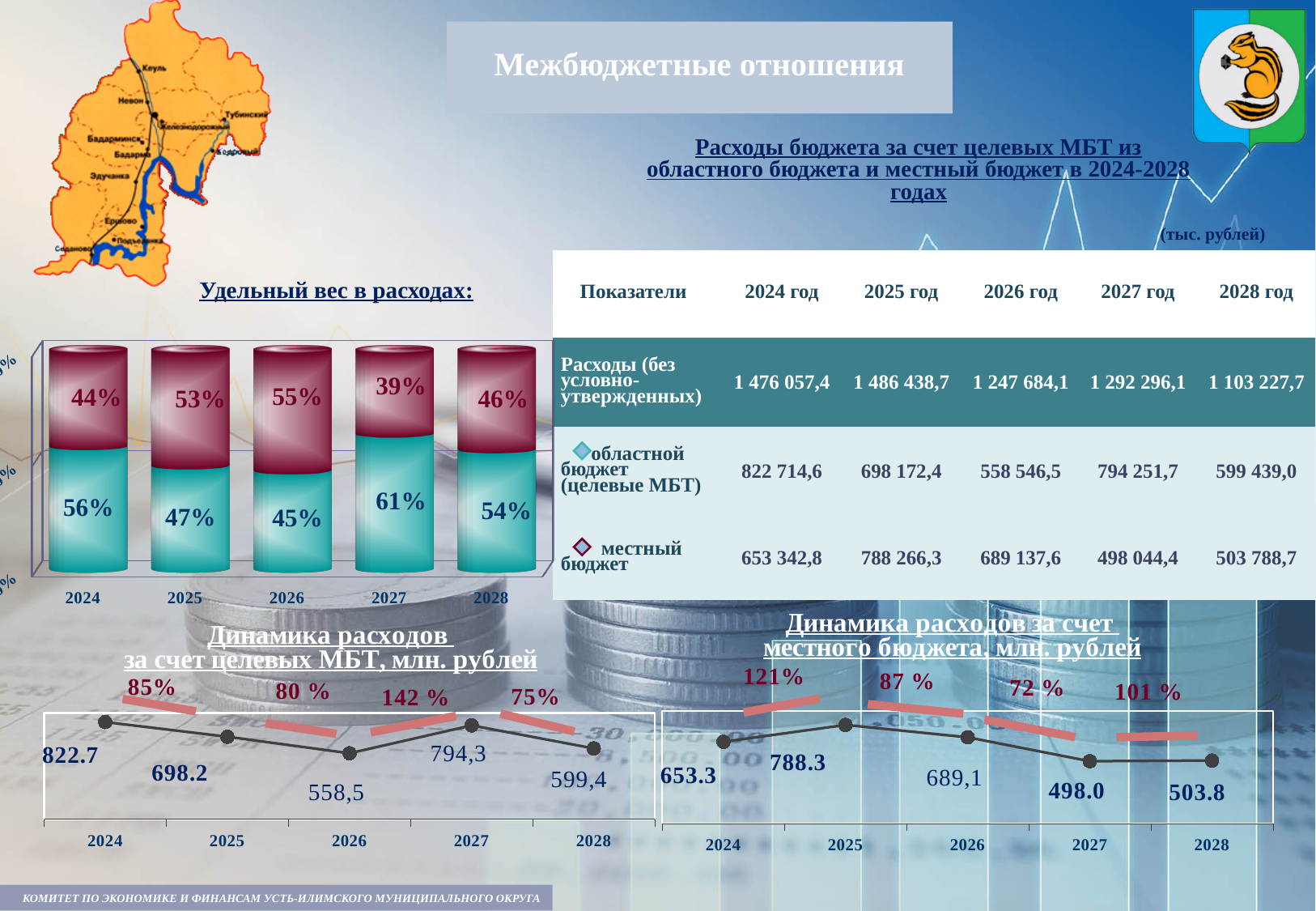
In the "Динамика расходов за счет целевых МБТ, млн. рублей" chart, what is the value for 2026? 558,5 In the "Удельный вес в расходах" chart, what is the value of the maroon upper segment for 2026? 55% In the "Удельный вес в расходах" chart, which year has the lowest value for the maroon upper segment? 2027 In the "Удельный вес в расходах" chart, what is the total of the stacked bar for 2024? 100% In the "Динамика расходов за счет местного бюджета, млн. рублей" chart, what is the difference between the 2025 value and the 2024 value? 135.0 In the "Динамика расходов за счет целевых МБТ, млн. рублей" chart, which is larger, the value for 2027 or the value for 2028? 2027 In the "Удельный вес в расходах" chart, how many years are shown on the x axis? 5 What kind of chart is the "Удельный вес в расходах" chart? Stacked bar chart In the "Удельный вес в расходах" chart, which year has the highest value for the teal lower segment? 2027 In the "Удельный вес в расходах" chart, what is the value of the teal lower segment for 2027? 61% In the "Динамика расходов за счет целевых МБТ, млн. рублей" chart, which year has the highest value? 2024 In the "Динамика расходов за счет местного бюджета, млн. рублей" chart, which year has the lowest value? 2027